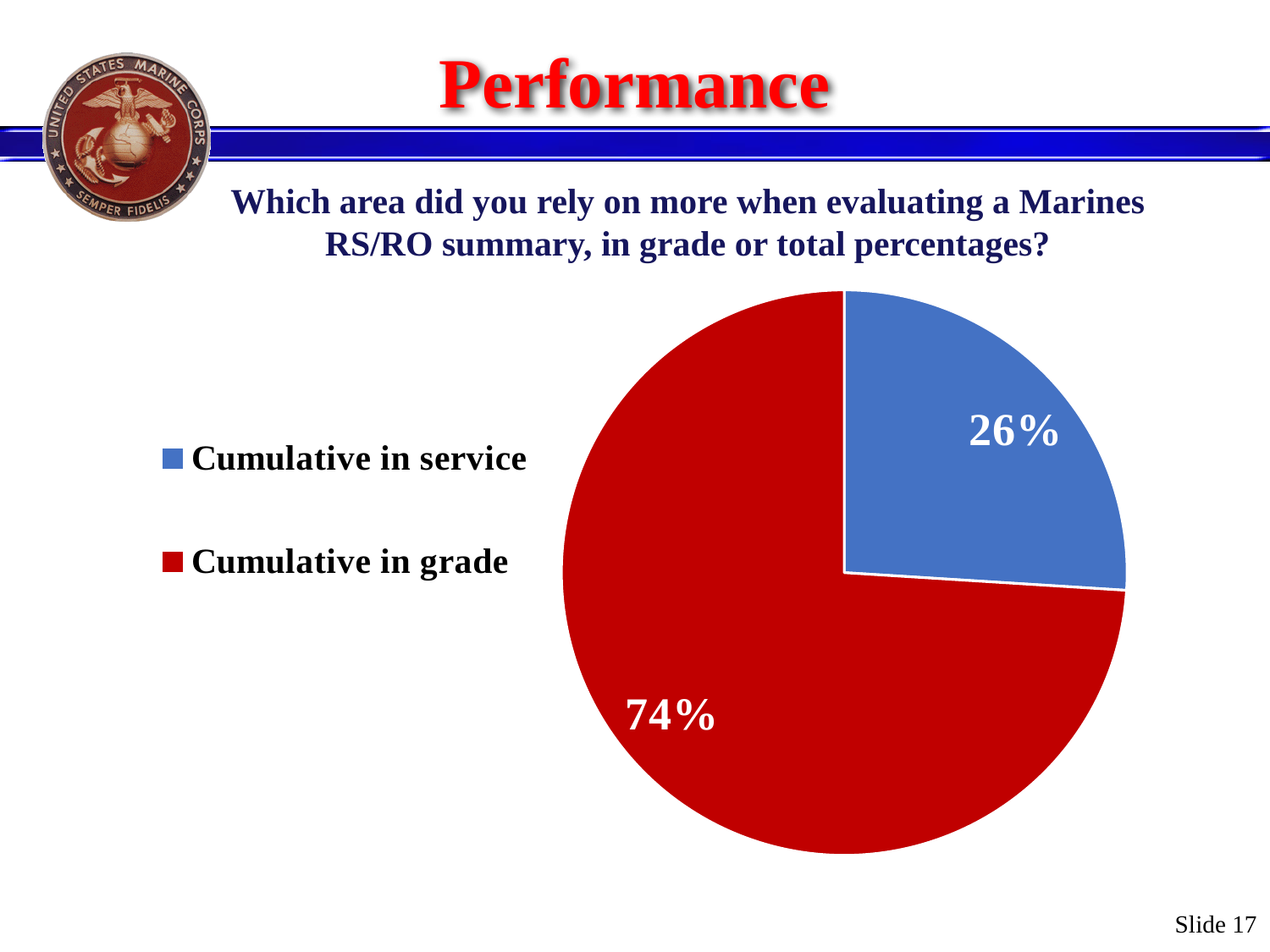
What percentage of the pie is labelled for Cumulative in service? 26% How many slices does the pie chart have? 2 What is the difference in percentage points between the Cumulative in grade slice and the Cumulative in service slice? 48 What kind of chart is shown on the slide? pie chart What colour is the Cumulative in grade slice? red What percentage of the pie is labelled for Cumulative in grade? 74% Which slice of the pie is the largest? Cumulative in grade What colour is the Cumulative in service slice? blue Which slice of the pie is the smallest? Cumulative in service How many entries does the legend list? 2 What share of the pie does the Cumulative in service slice represent? 26% Which is larger, the Cumulative in service slice or the Cumulative in grade slice? Cumulative in grade